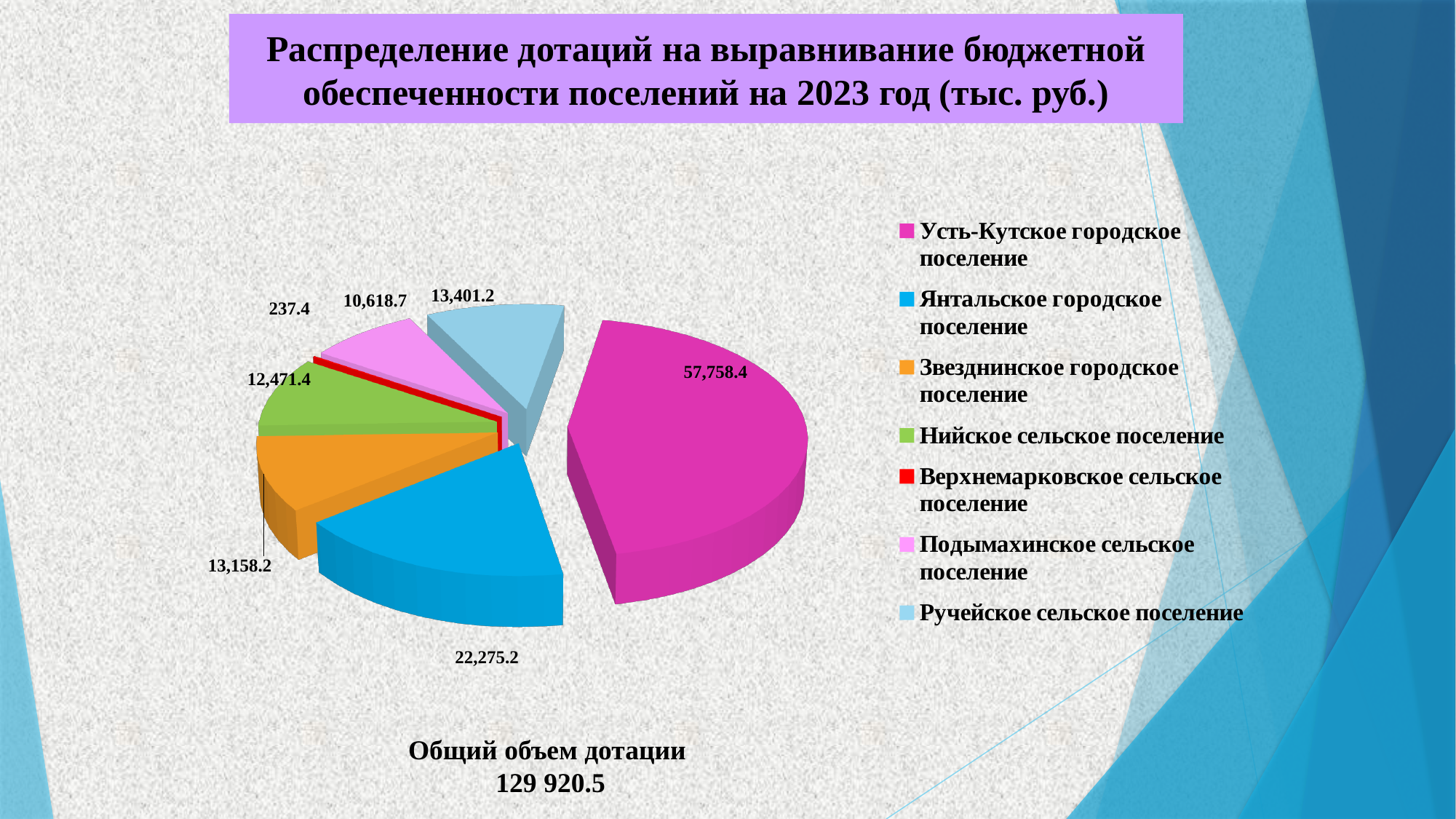
How many settlements (slices) are shown in the pie chart? 7 What is the value for Усть-Кутское городское поселение? 57,758.4 What is the total volume of the subsidy shown on the slide? 129 920.5 Which settlement receives the smallest share of the subsidy? Верхнемарковское сельское поселение What is the difference between the values for Усть-Кутское городское поселение and Янтальское городское поселение? 35,483.2 What colour is the slice for Нийское сельское поселение? Green What is the value for Верхнемарковское сельское поселение? 237.4 What is the value for Янтальское городское поселение? 22,275.2 What is the value for Подымахинское сельское поселение? 10,618.7 What type of chart is shown on the slide? Pie chart Which settlement receives the largest share of the subsidy? Усть-Кутское городское поселение Which is larger: the value for Ручейское сельское поселение or Звезднинское городское поселение? Ручейское сельское поселение